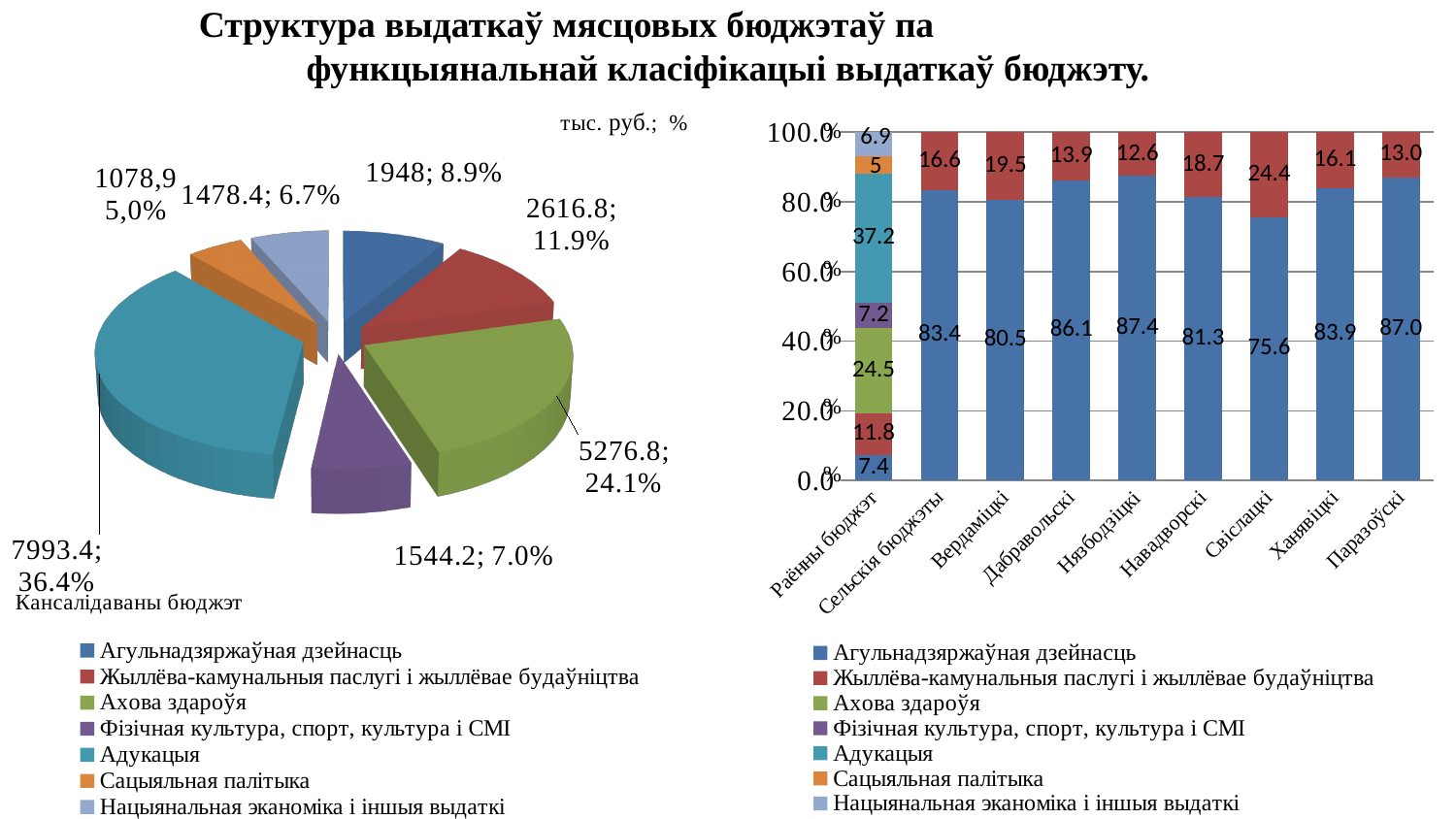
In the stacked bar chart on the right, what is the difference between the blue segment values for Паразоўскі and Сельскія бюджэты? 3.6 In the stacked bar chart on the right, what is the value of the Адукацыя segment for Раённы бюджэт? 37.2 In the pie chart on the left, how many slices are there? 7 In the pie chart on the left, which category has the largest slice? Адукацыя In the stacked bar chart on the right, how many categories are shown on the x axis? 9 In the stacked bar chart on the right, what is the value of the red segment (Жыллёва-камунальныя паслугі і жыллёвае будаўніцтва) for Вердаміцкі? 19.5 In the pie chart on the left, what value and share are shown for Адукацыя? 7993.4; 36.4% How many series does the legend of the stacked bar chart on the right list? 7 In the stacked bar chart on the right, which category has the highest value for the blue segment (Агульнадзяржаўная дзейнасць)? Нязбодзіцкі In the stacked bar chart on the right, what is the value of the blue segment (Агульнадзяржаўная дзейнасць) for Свіслацкі? 75.6 In the pie chart on the left, which category has the smallest slice? Сацыяльная палітыка In the pie chart on the left, what share does Ахова здароўя have? 24.1%